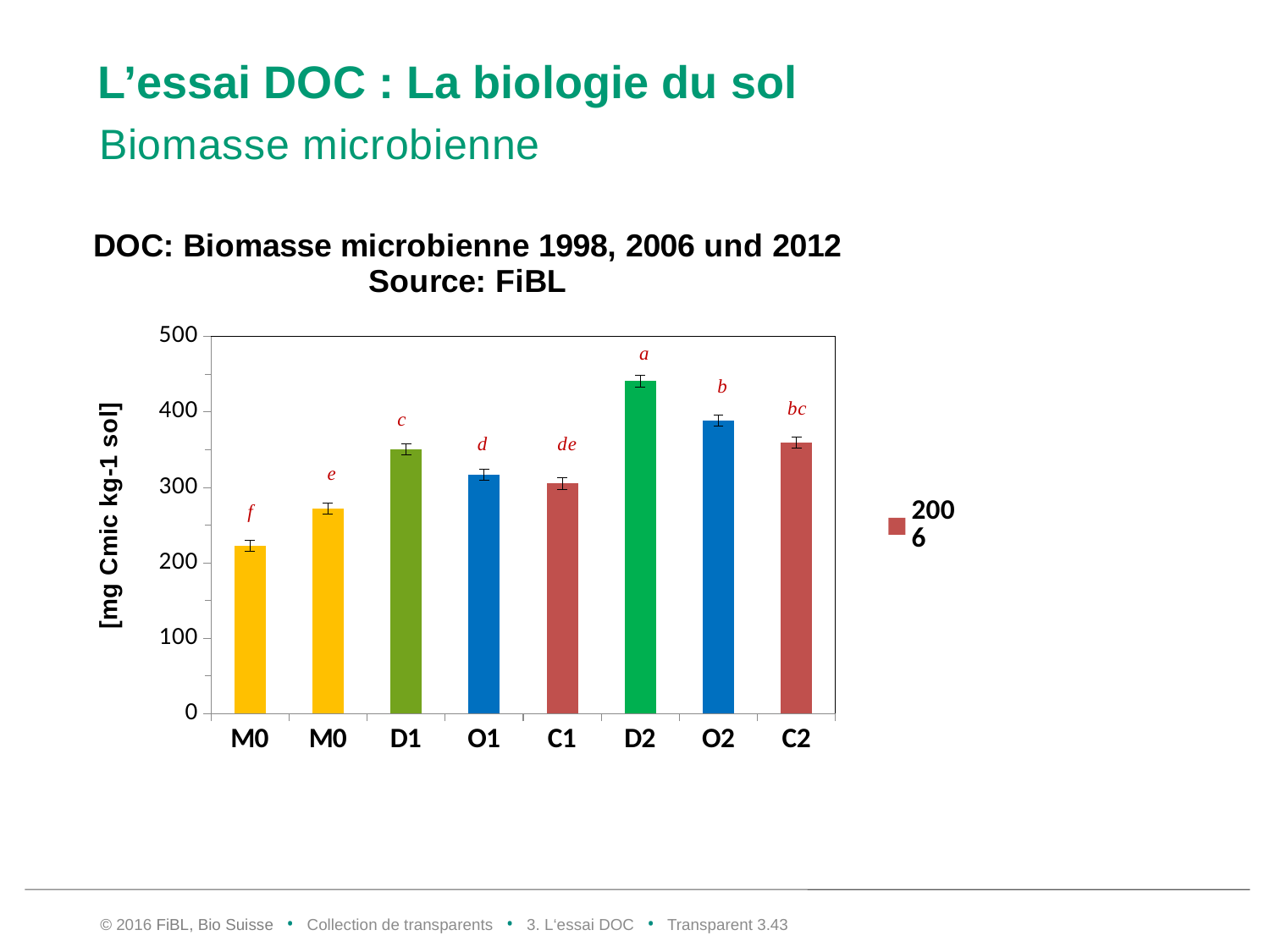
Is the value for C2 greater or less than 400? less What is the label of the y axis? [mg Cmic kg-1 sol] Which is larger, the value for D2 or the value for O2? D2 Which letter is printed above the D2 bar? a Which bar is the lowest in the chart? the leftmost M0 bar How many bars are plotted in the chart? 8 What kind of chart is shown on the slide? bar chart Is the value for the leftmost M0 bar greater or less than 300? less Which category has the highest bar in the chart? D2 Which is larger, the value for D1 or the value for C1? D1 Is the value for D1 greater or less than 300? greater